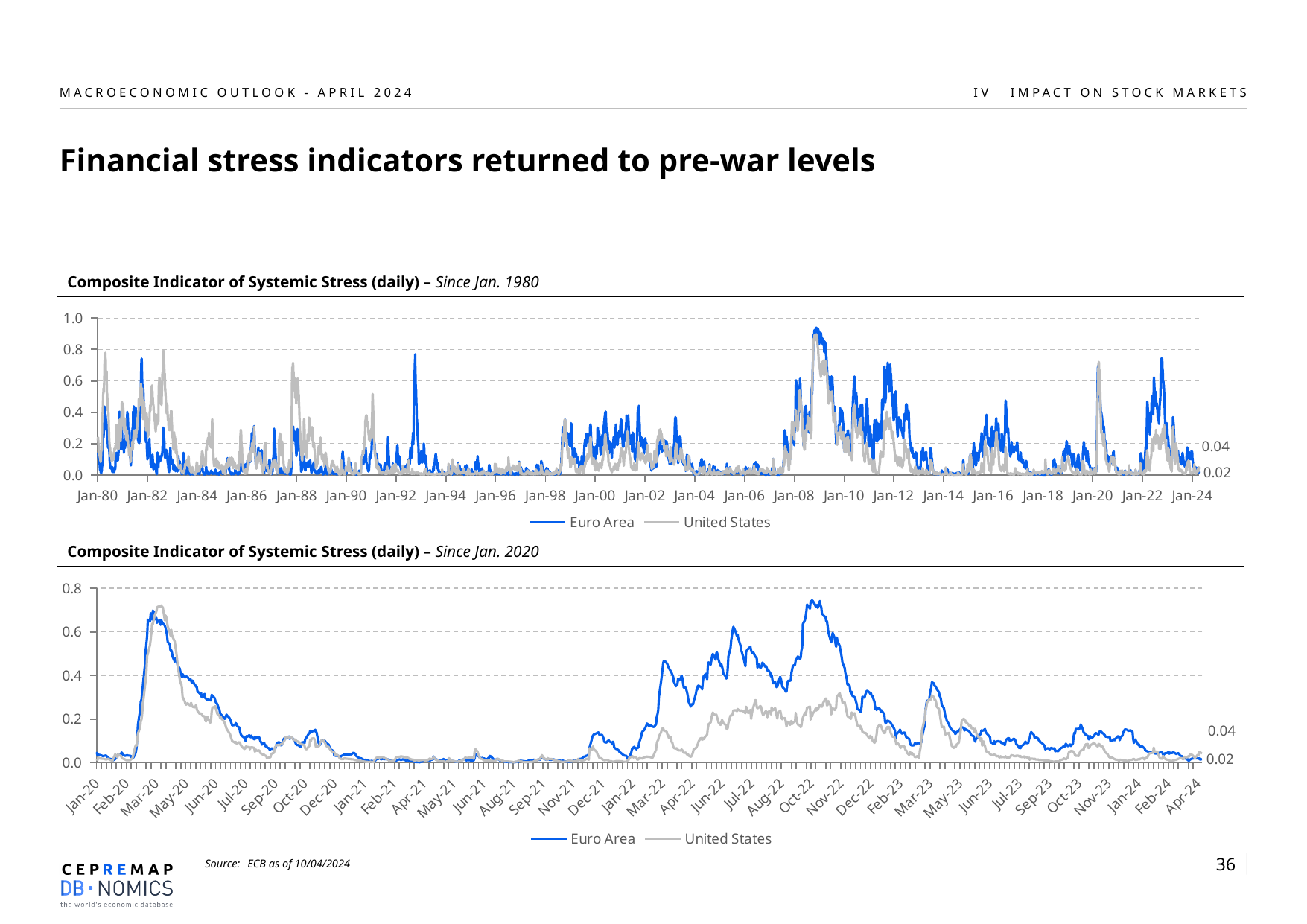
In the bottom chart (Since Jan. 2020), is the United States value around Jul-22 greater or less than 0.4? less In the bottom chart (Since Jan. 2020), is the Euro Area peak around Oct-22 greater or less than 0.6? greater In the bottom chart (Since Jan. 2020), is the United States peak around Mar-20 greater or less than 0.6? greater Which two series are shown in the legend of the top chart (Since Jan. 1980)? Euro Area and United States In the bottom chart (Since Jan. 2020), which series is higher around Oct-22, Euro Area or United States? Euro Area What are the two latest values labelled at the right edge of the bottom chart (Since Jan. 2020)? 0.04 and 0.02 How many series does the legend of the bottom chart (Since Jan. 2020) list? 2 What is the first x-axis label on the top chart (Since Jan. 1980)? Jan-80 What kind of chart is the top chart, 'Composite Indicator of Systemic Stress (daily) – Since Jan. 1980'? Line chart In the bottom chart (Since Jan. 2020), does the Euro Area series rise or fall from Oct-22 to Feb-24? fall